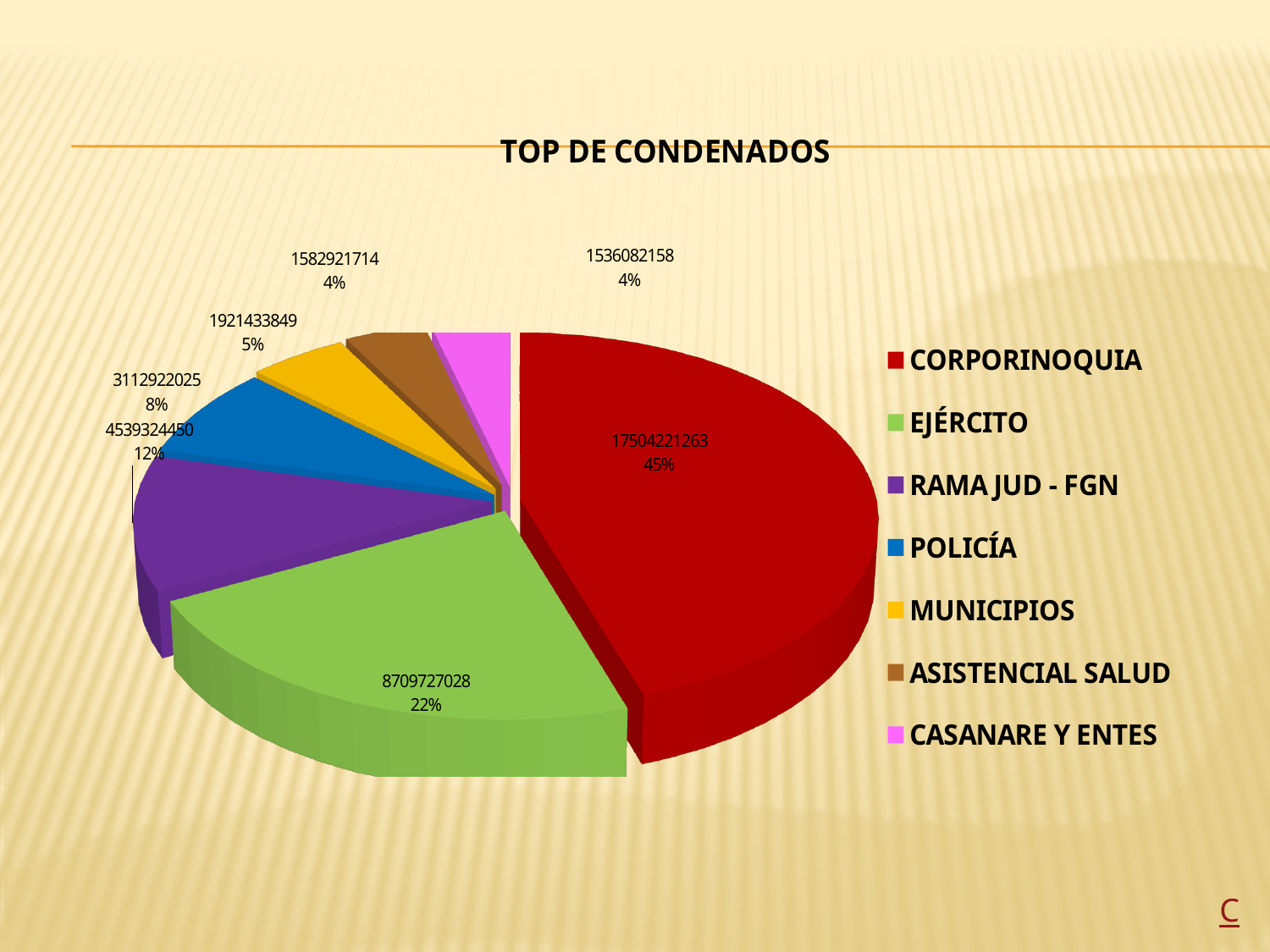
What is the value for RAMA JUD - FGN? 4539324450 What is the value for MUNICIPIOS? 1921433849 Which category has the smallest value? CASANARE Y ENTES What is the difference between the values for CORPORINOQUIA and EJÉRCITO? 8794494235 What share of the pie does EJÉRCITO represent? 22% What share of the pie does POLICÍA represent? 8% How many categories does the legend list? 7 What is the title of the chart? TOP DE CONDENADOS What kind of chart is shown on the slide? pie chart What is the value for CORPORINOQUIA? 17504221263 Which category has the largest slice? CORPORINOQUIA Which is larger, the value for EJÉRCITO or the value for RAMA JUD - FGN? EJÉRCITO